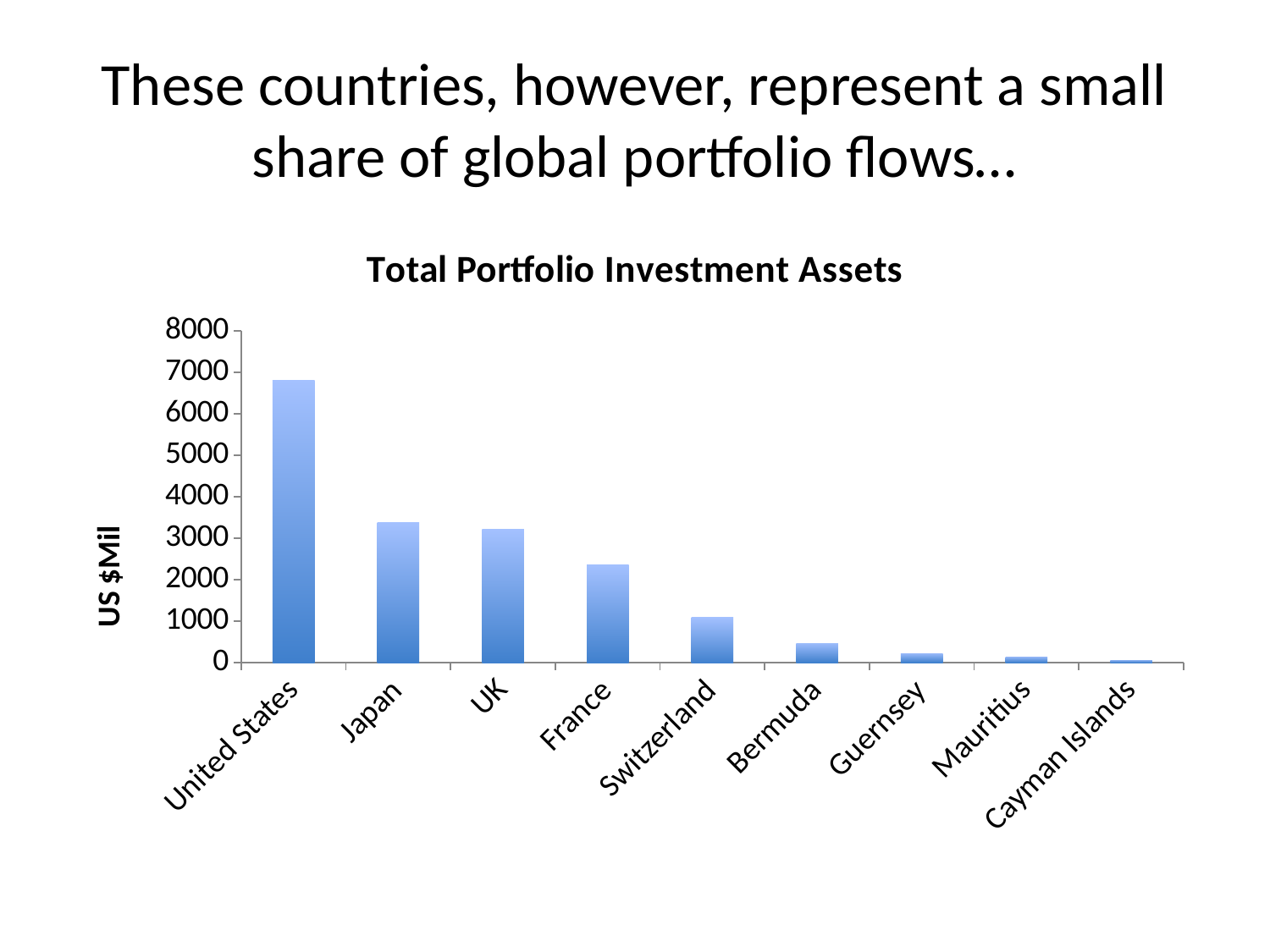
Is the value for Bermuda greater or less than 1000? less Which has a larger value, France or Switzerland? France What kind of chart is shown on the slide? Bar chart Is the value for France greater or less than 2000? greater What is the label on the vertical axis of the chart? US $Mil Do the values rise or fall moving from left to right along the x axis? Fall How many countries are shown on the x axis of the chart? 9 Which country has the highest total portfolio investment assets? United States Is the value for Japan greater or less than 3000? greater Which country has the lowest total portfolio investment assets? Cayman Islands What is the title of the chart? Total Portfolio Investment Assets